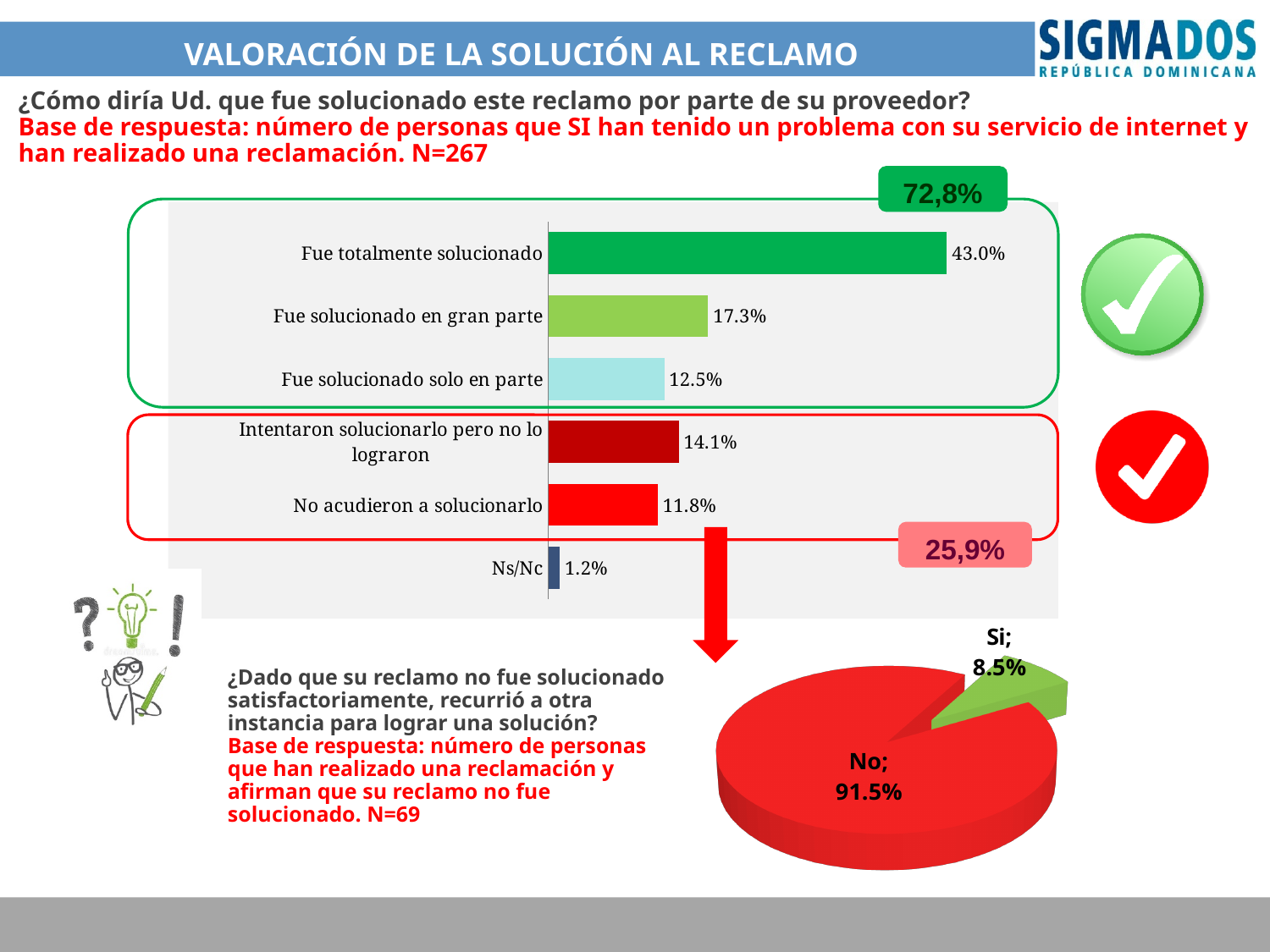
In the pie chart at the bottom, what is the difference between the "No" and "Si" slices? 83.0% In the bar chart, which category has the highest value? Fue totalmente solucionado In the bar chart, which category has the lowest value? Ns/Nc In the bar chart, what is the value for "Intentaron solucionarlo pero no lo lograron"? 14.1% In the bar chart, which is larger: "Fue solucionado en gran parte" or "Fue solucionado solo en parte"? Fue solucionado en gran parte In the bar chart, what is the difference between "Fue totalmente solucionado" and "Fue solucionado en gran parte"? 25.7% How many categories does the bar chart show? 6 In the bar chart, what is the value for "Ns/Nc"? 1.2% What type of chart is the top chart on the slide? Bar chart In the bar chart, what is the value for "Fue totalmente solucionado"? 43.0% What type of chart is the bottom chart on the slide? Pie chart In the pie chart at the bottom, what share does "No" have? 91.5%